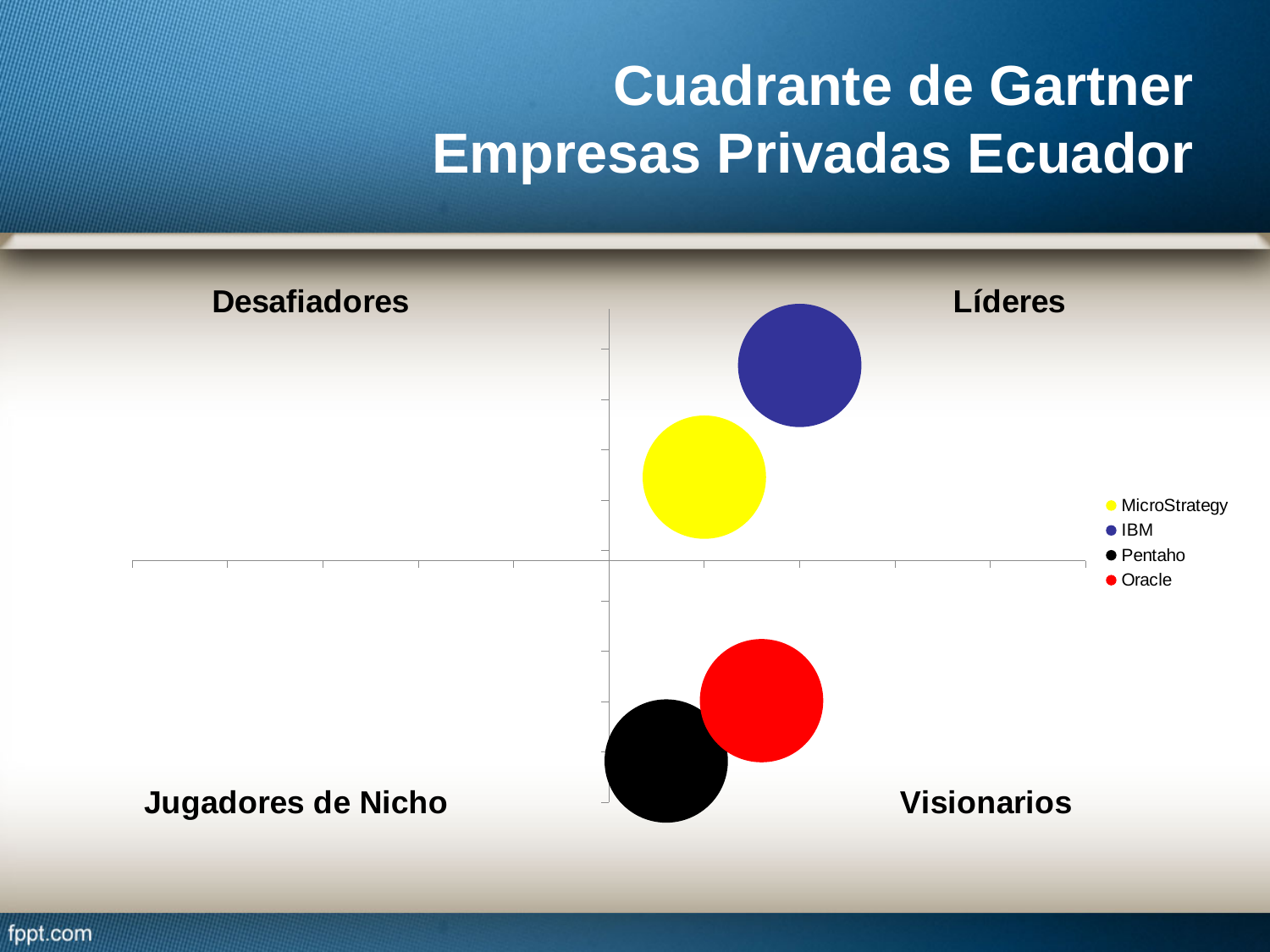
Which series has the highest vertical position on the chart? IBM In which quadrant of the chart is the Oracle bubble located? Visionarios Which series has the lowest vertical position on the chart? Pentaho How many bubbles are plotted on the chart? 4 Which series is positioned further to the right on the chart, Oracle or Pentaho? Oracle Which series is positioned higher on the chart, IBM or MicroStrategy? IBM What is the title of the slide containing the chart? Cuadrante de Gartner Empresas Privadas Ecuador How many series does the legend list? 4 In which quadrant of the chart is the IBM bubble located? Líderes What kind of chart is shown on the slide? bubble chart Which series is positioned further to the right on the chart, IBM or MicroStrategy? IBM What colour is the bubble for Pentaho? black